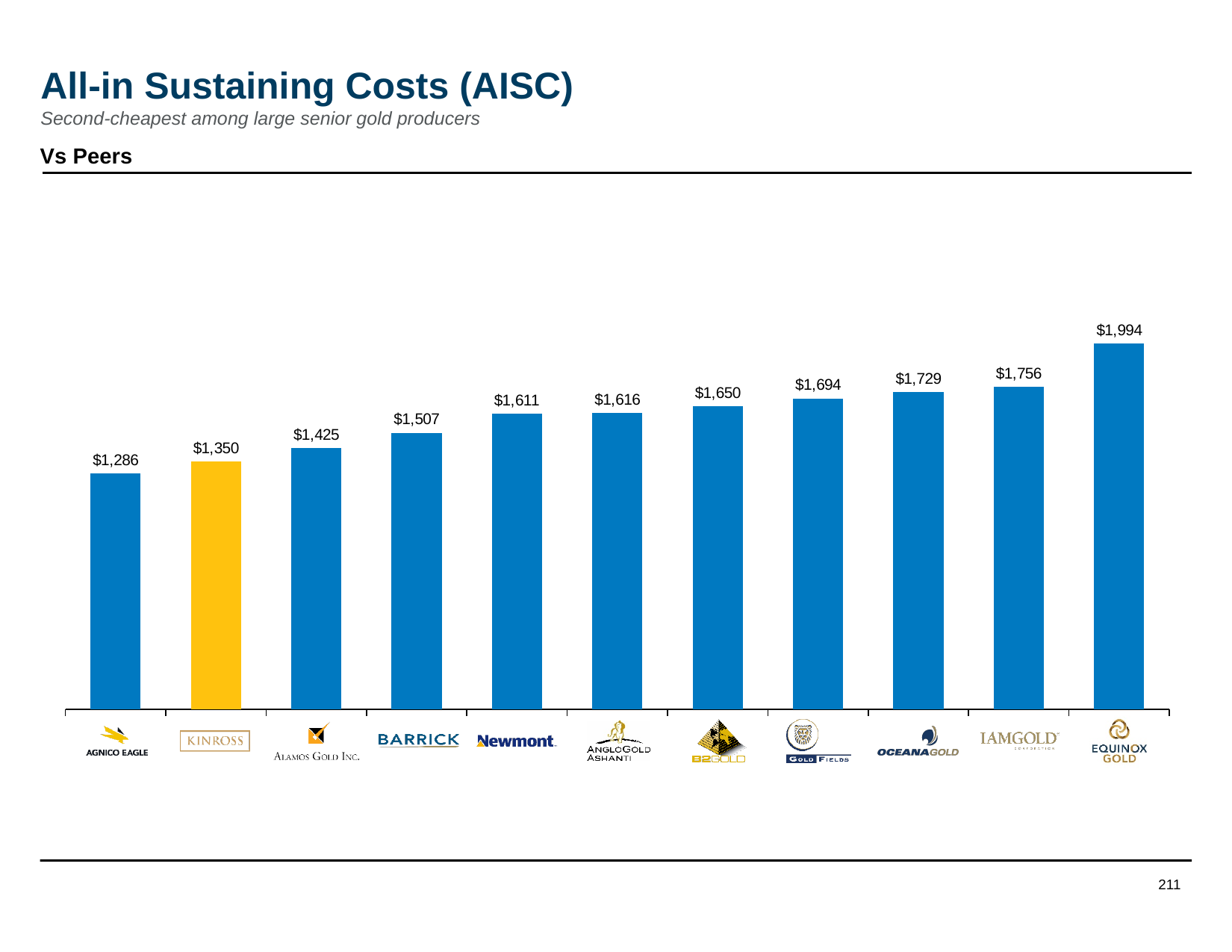
What is the difference between the AISC of Equinox Gold and IAMGOLD? $238 How many companies are shown on the chart? 11 What is the AISC value shown for Barrick? $1,507 What is the AISC value shown for Equinox Gold? $1,994 Which company has the highest AISC on the chart? Equinox Gold What kind of chart is shown on the slide? Bar chart Which has a higher AISC, Newmont or Alamos Gold? Newmont Which company's bar is highlighted in yellow rather than blue? Kinross Do the AISC values rise or fall from left to right across the chart? Rise Which company has the lowest AISC on the chart? Agnico Eagle What is the AISC value shown for Kinross? $1,350 What is the difference between the AISC of Kinross and Agnico Eagle? $64